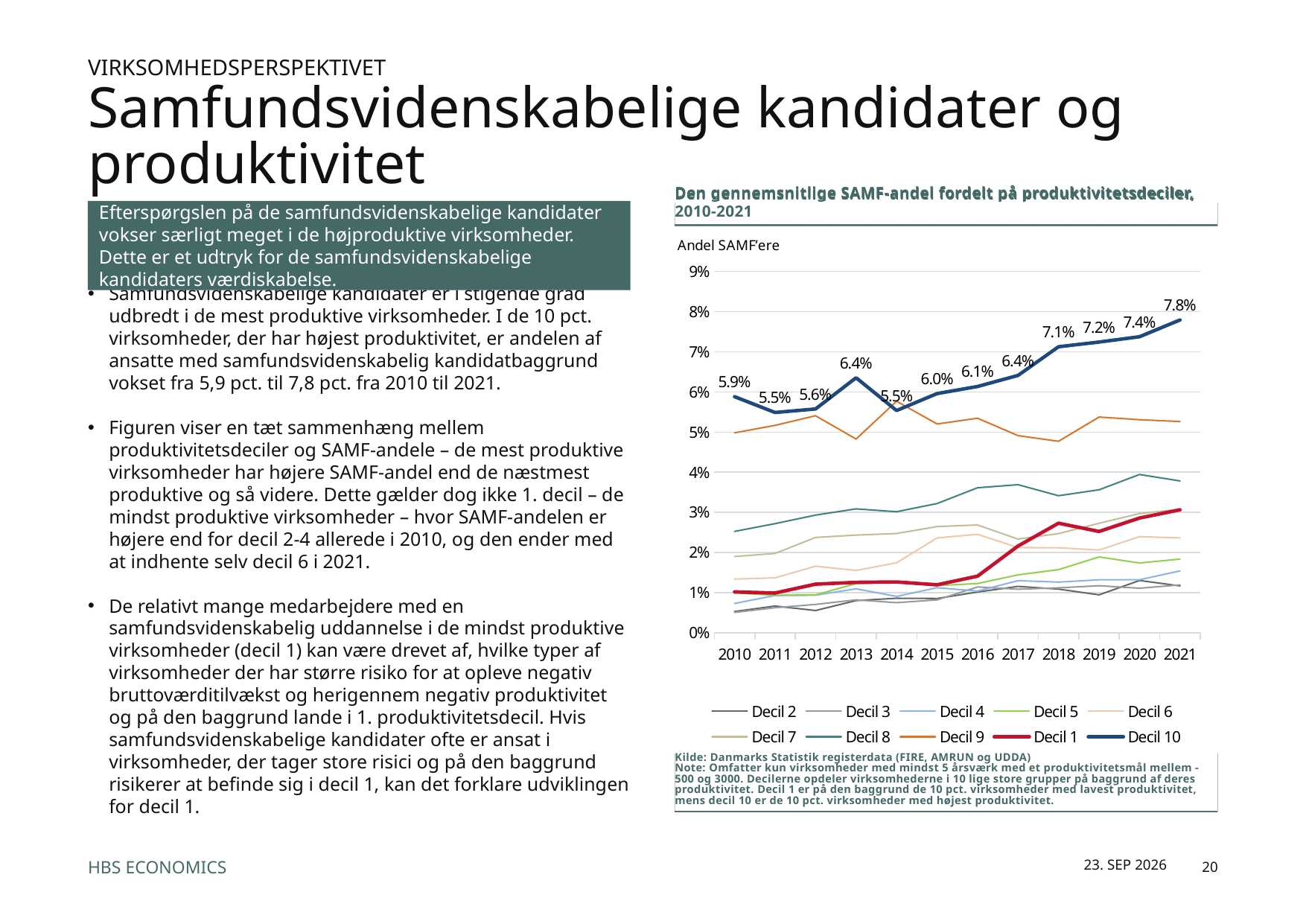
How many series does the legend list? 10 What is the value for Decil 10 in 2018? 7.1% What is the value for Decil 10 in 2021? 7.8% Does the Decil 10 line generally rise or fall from 2010 to 2021? Rise Which is larger for Decil 10: the value in 2013 or the value in 2014? 2013 (6.4%) What kind of chart is shown on the slide? Line chart Is the value for Decil 9 in 2021 greater or less than 6%? less By how many percentage points did the Decil 10 value change from 2010 to 2021? 1.9 percentage points How many years are shown on the x axis? 12 What is the value for Decil 10 in 2010? 5.9% In which year does Decil 10 reach its highest value? 2021 Is the value for Decil 1 in 2010 greater or less than 2%? less